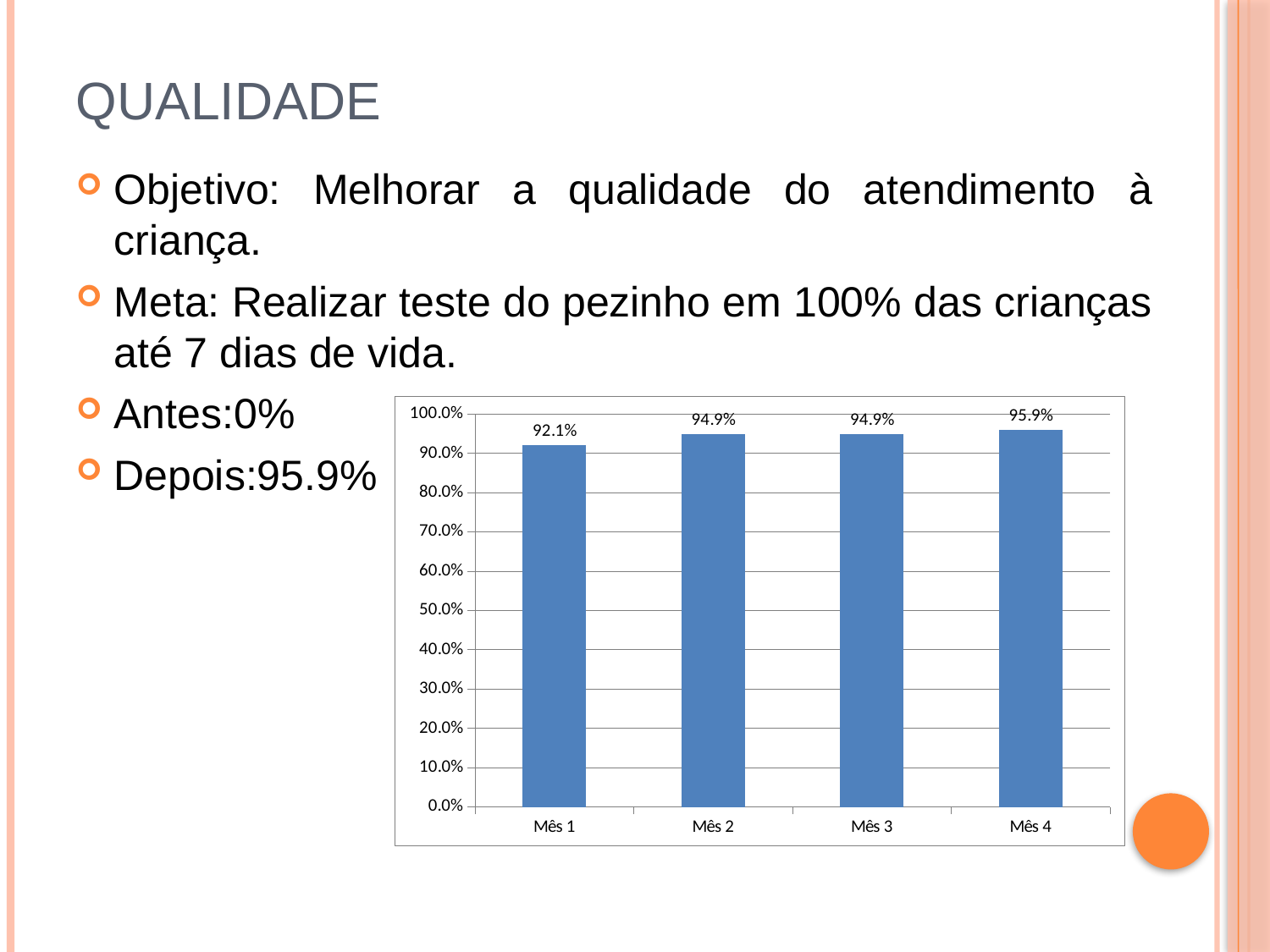
Do the values generally rise or fall from Mês 1 to Mês 4? rise Is the value for Mês 1 greater or less than 90.0%? greater What kind of chart is shown on the slide? bar chart What is the value for Mês 1? 92.1% What is the value for Mês 2? 94.9% What is the difference between the values for Mês 2 and Mês 1? 2.8% Which is larger, the value for Mês 1 or the value for Mês 3? Mês 3 Which month has the lowest value? Mês 1 What is the difference between the values for Mês 4 and Mês 1? 3.8% How many months are shown on the x axis? 4 Which month has the highest value? Mês 4 What is the value for Mês 4? 95.9%